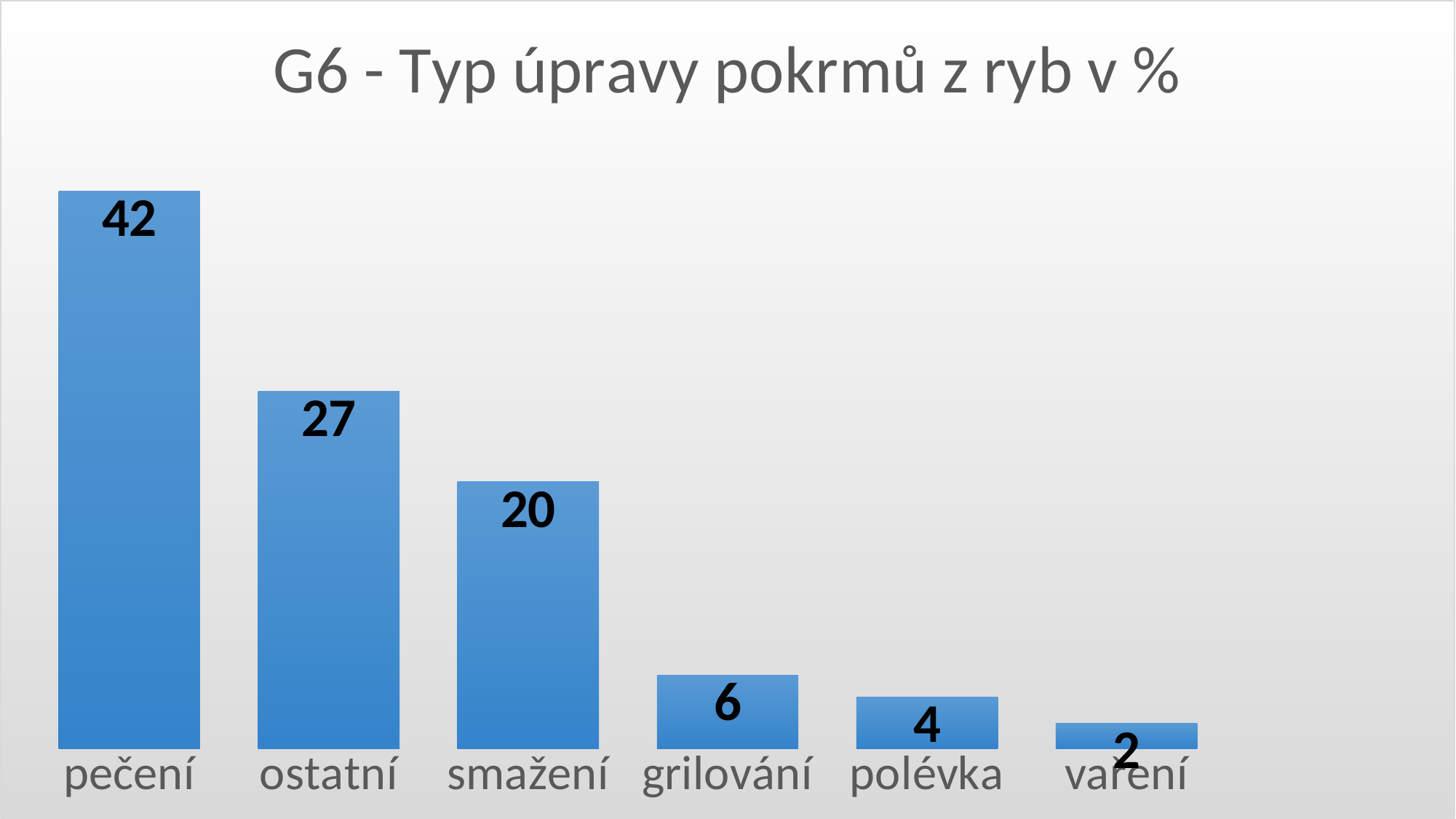
What is the title of the chart? G6 - Typ úpravy pokrmů z ryb v % What is the value for ostatní? 27 Which is larger, the value for smažení or the value for polévka? smažení What is the value for smažení? 20 What is the value for pečení? 42 What is the value for vaření? 2 What kind of chart is shown on the slide? bar chart What is the difference between the values for pečení and ostatní? 15 How many categories are shown in the chart? 6 Which category has the lowest value? vaření What is the value for grilování? 6 Which category has the highest value? pečení